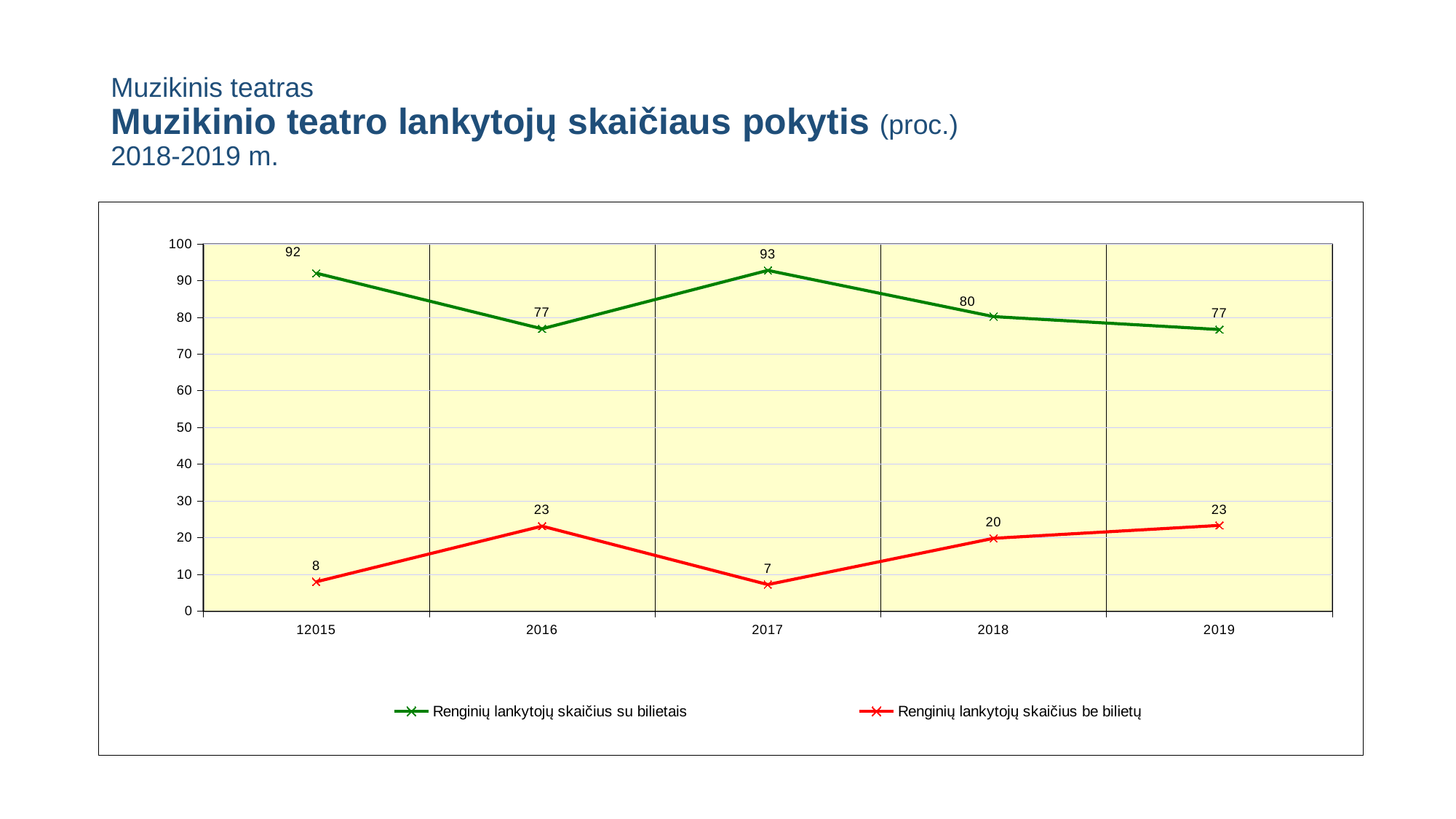
What is the difference between 'Renginių lankytojų skaičius su bilietais' and 'Renginių lankytojų skaičius be bilietų' in 2016? 54 How many series does the legend list? 2 What type of chart is shown on the slide? line chart What is the value of 'Renginių lankytojų skaičius su bilietais' in 2019? 77 What colour is the line for 'Renginių lankytojų skaičius be bilietų'? red In which year is 'Renginių lankytojų skaičius be bilietų' lowest? 2017 Which is larger in 2018: 'Renginių lankytojų skaičius su bilietais' or 'Renginių lankytojų skaičius be bilietų'? Renginių lankytojų skaičius su bilietais How many points are plotted along the x axis for each series? 5 What is the value of 'Renginių lankytojų skaičius be bilietų' in 2018? 20 In which year is 'Renginių lankytojų skaičius su bilietais' highest? 2017 Does 'Renginių lankytojų skaičius be bilietų' rise or fall from 2017 to 2019? rise What is the value of 'Renginių lankytojų skaičius su bilietais' in 2017? 93